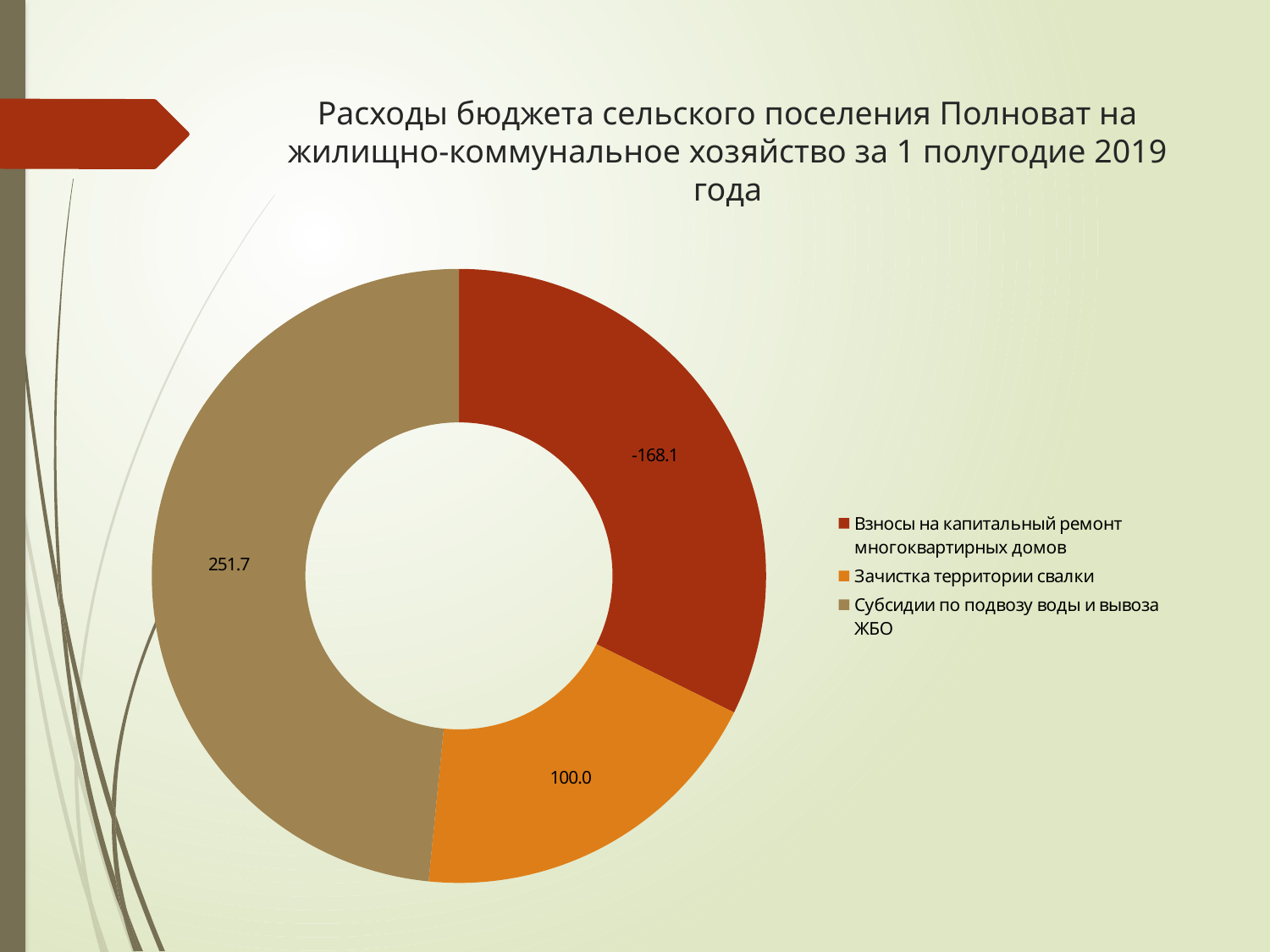
What is the value shown for Субсидии по подвозу воды и вывоза ЖБО? 251.7 What colour is the slice for Зачистка территории свалки? Orange What value is printed on the slice for Взносы на капитальный ремонт многоквартирных домов? -168.1 What is the difference between the values for Субсидии по подвозу воды и вывоза ЖБО and Зачистка территории свалки? 151.7 How many categories are shown in the doughnut chart? 3 What is the value shown for Зачистка территории свалки? 100.0 Which is larger: the value for Субсидии по подвозу воды и вывоза ЖБО or the value for Зачистка территории свалки? Субсидии по подвозу воды и вывоза ЖБО What is the title of the chart? Расходы бюджета сельского поселения Полноват на жилищно-коммунальное хозяйство за 1 полугодие 2019 года Which category has the largest slice of the doughnut? Субсидии по подвозу воды и вывоза ЖБО How many entries does the legend list? 3 What kind of chart is shown on the slide? Doughnut chart